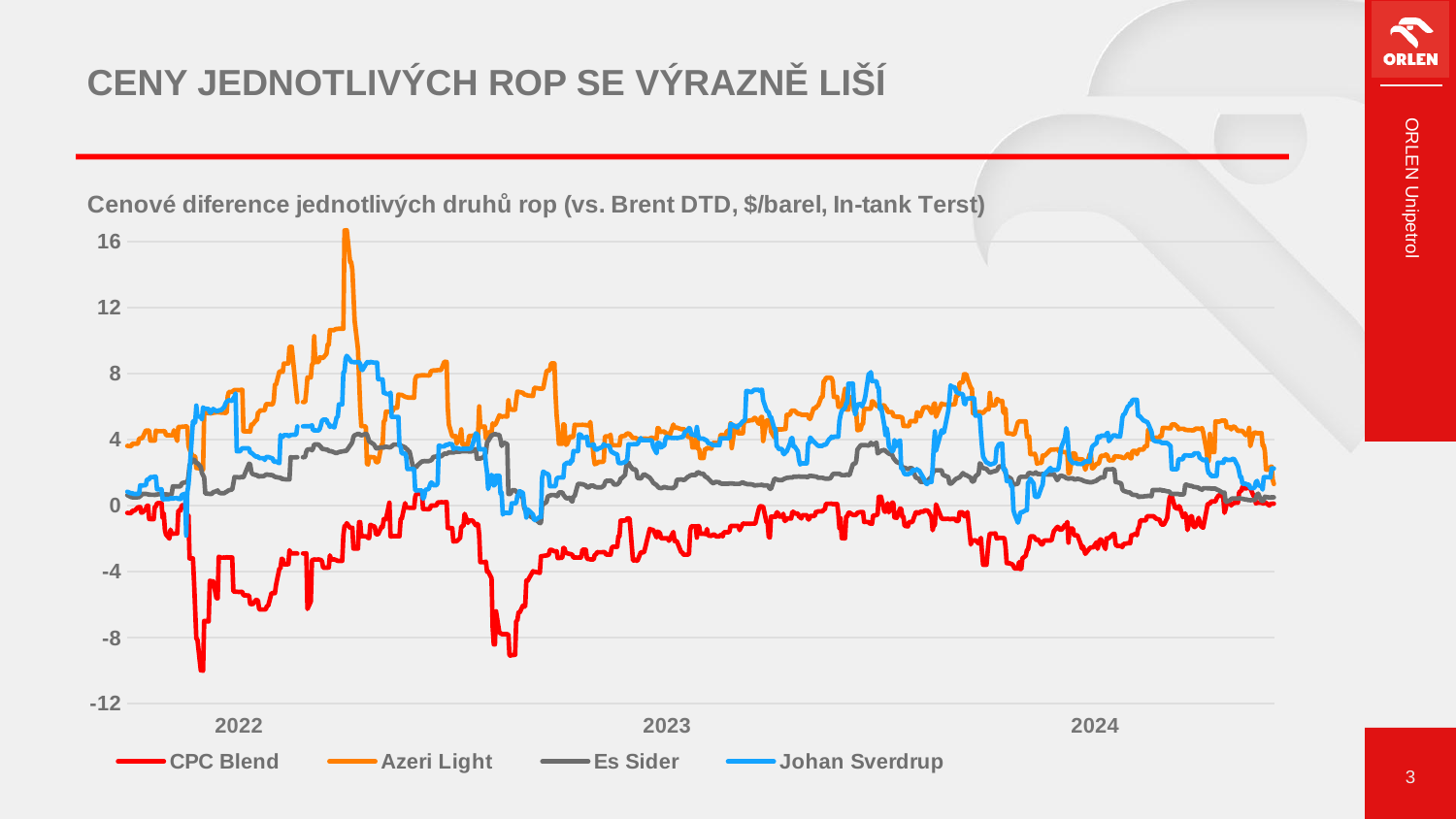
Is the peak value of Azeri Light greater or less than 12? greater Which series reaches the highest value on the chart? Azeri Light What kind of chart is shown on the slide? line chart What is the title of the chart? Cenové diference jednotlivých druhů rop (vs. Brent DTD, $/barel, In-tank Terst) How many series does the legend list? 4 Is the lowest value of CPC Blend greater or less than -8? less Which series is higher for most of the period, CPC Blend or Azeri Light? Azeri Light What is the highest value shown on the vertical axis? 16 Which series reaches the lowest value on the chart? CPC Blend Is the highest value of Es Sider greater or less than 8? less Which series is higher for most of the period, Es Sider or CPC Blend? Es Sider Which series is drawn in red? CPC Blend